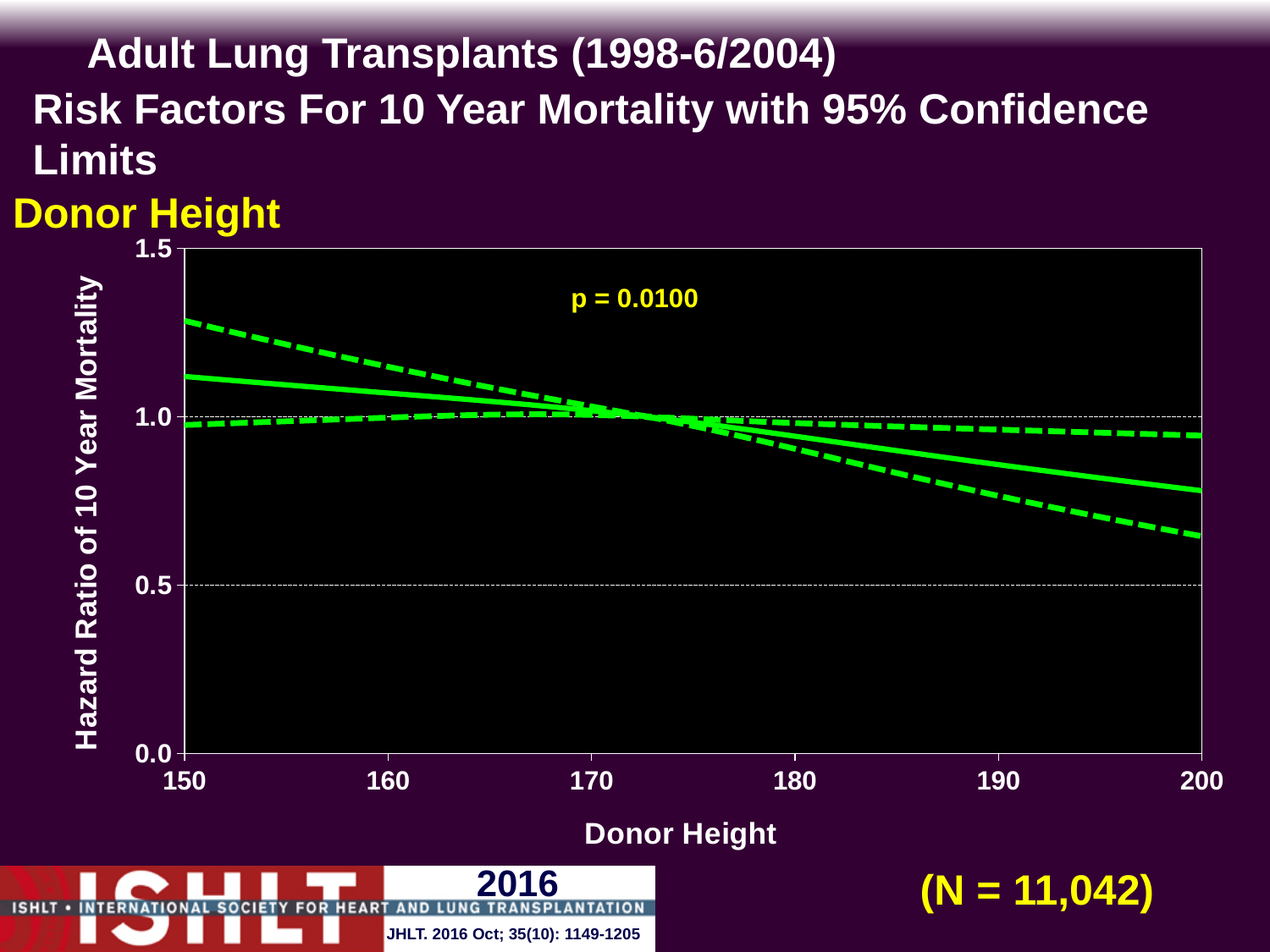
What is the highest donor height value shown on the x axis? 200 What is the sample size (N) shown on the slide? N = 11,042 How many lines are plotted on the chart? 3 Is the upper dashed confidence limit at a donor height of 150 greater or less than 1.0? greater Is the lower dashed confidence limit at a donor height of 200 greater or less than 1.0? less What is the label of the y axis? Hazard Ratio of 10 Year Mortality Is the hazard ratio on the solid line at a donor height of 200 greater or less than 0.5? greater What p-value is printed on the chart? p = 0.0100 Does the solid hazard ratio line rise or fall as donor height increases from 150 to 200? fall What kind of chart is shown on the slide? line chart